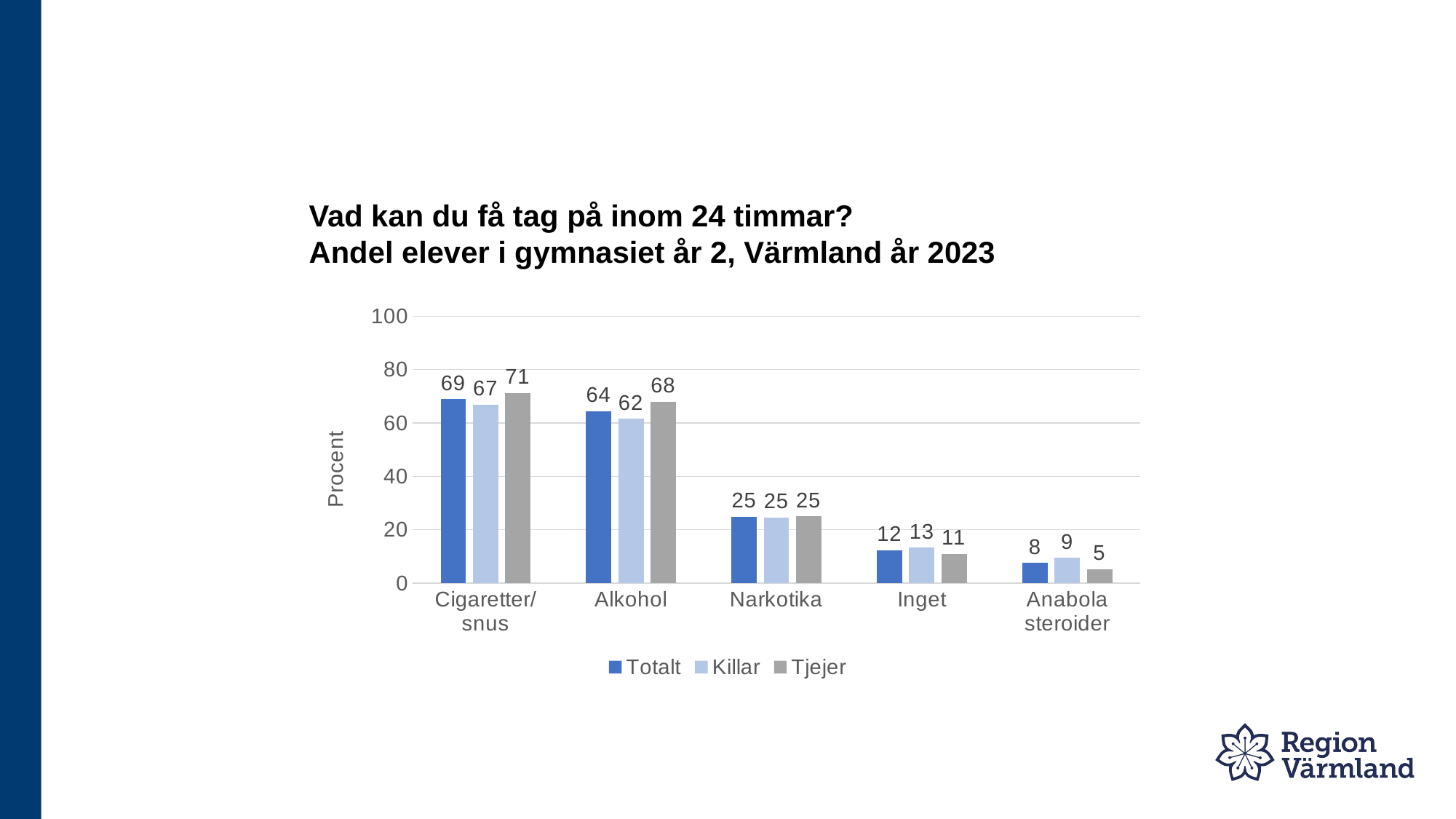
How many categories are shown on the x axis? 5 Which is larger for Anabola steroider, the Killar value or the Tjejer value? Killar What is the label of the y axis? Procent Is the Totalt value for Alkohol greater or less than 60? greater Which category has the highest Tjejer value? Cigaretter/snus What is the Killar value for Inget? 13 Which category has the lowest Totalt value? Anabola steroider What is the difference between the Tjejer and Killar values for Cigaretter/snus? 4 How many series does the legend list? 3 What is the Tjejer value for Alkohol? 68 What kind of chart is shown on the slide? Bar chart What is the Totalt value for Cigaretter/snus? 69